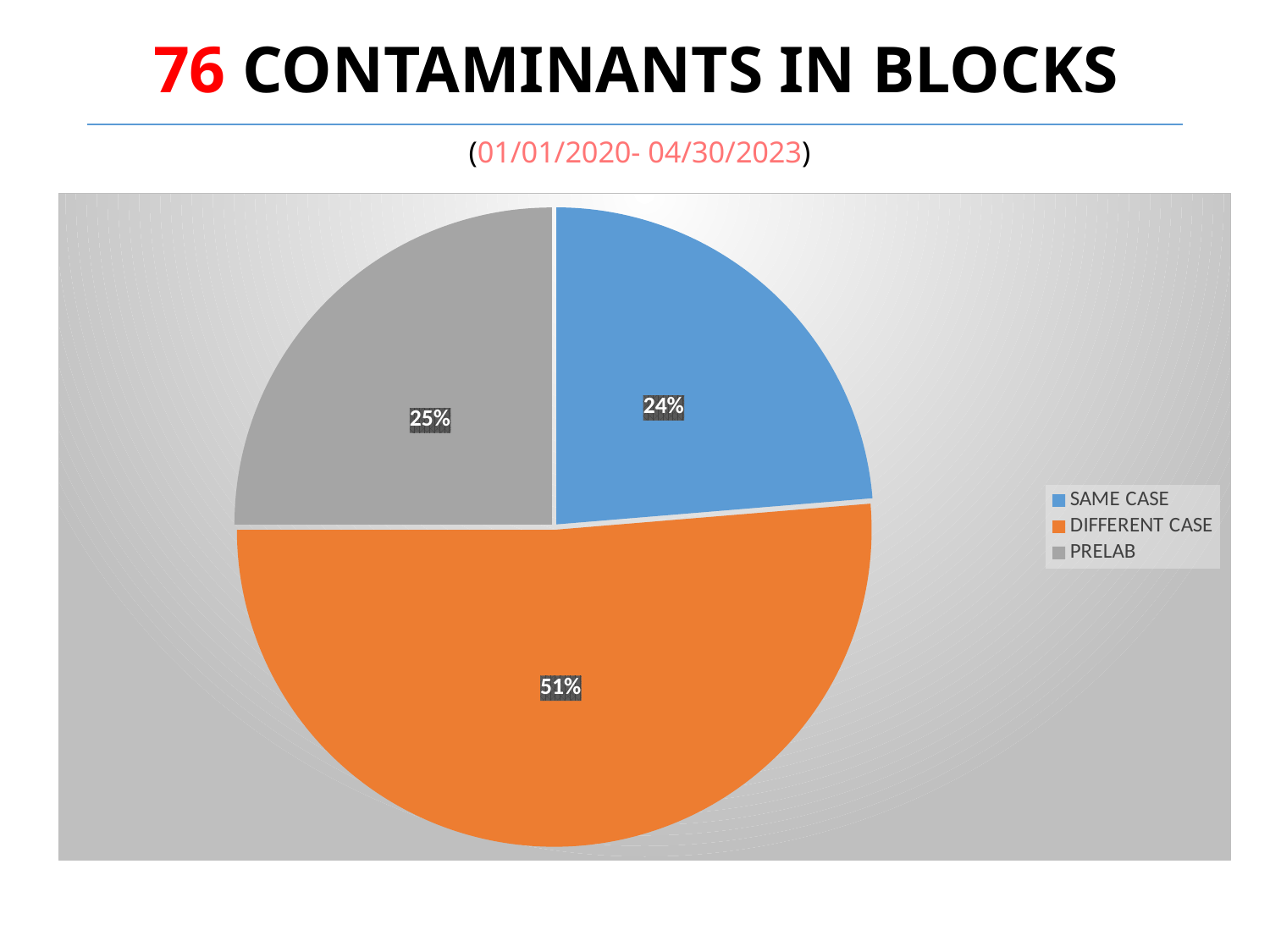
What share of the pie does SAME CASE represent? 24% What is the difference in percentage points between PRELAB and SAME CASE? 1 How many categories does the legend list? 3 What is the difference in percentage points between DIFFERENT CASE and PRELAB? 26 What kind of chart is shown on the slide? pie chart What date range is shown under the slide title? 01/01/2020- 04/30/2023 Is the share for DIFFERENT CASE greater or less than 50%? greater Which category has the largest slice of the pie? DIFFERENT CASE What share of the pie does DIFFERENT CASE represent? 51% Which colour represents PRELAB in the pie chart? gray Which category has the smallest slice of the pie? SAME CASE What share of the pie does PRELAB represent? 25%